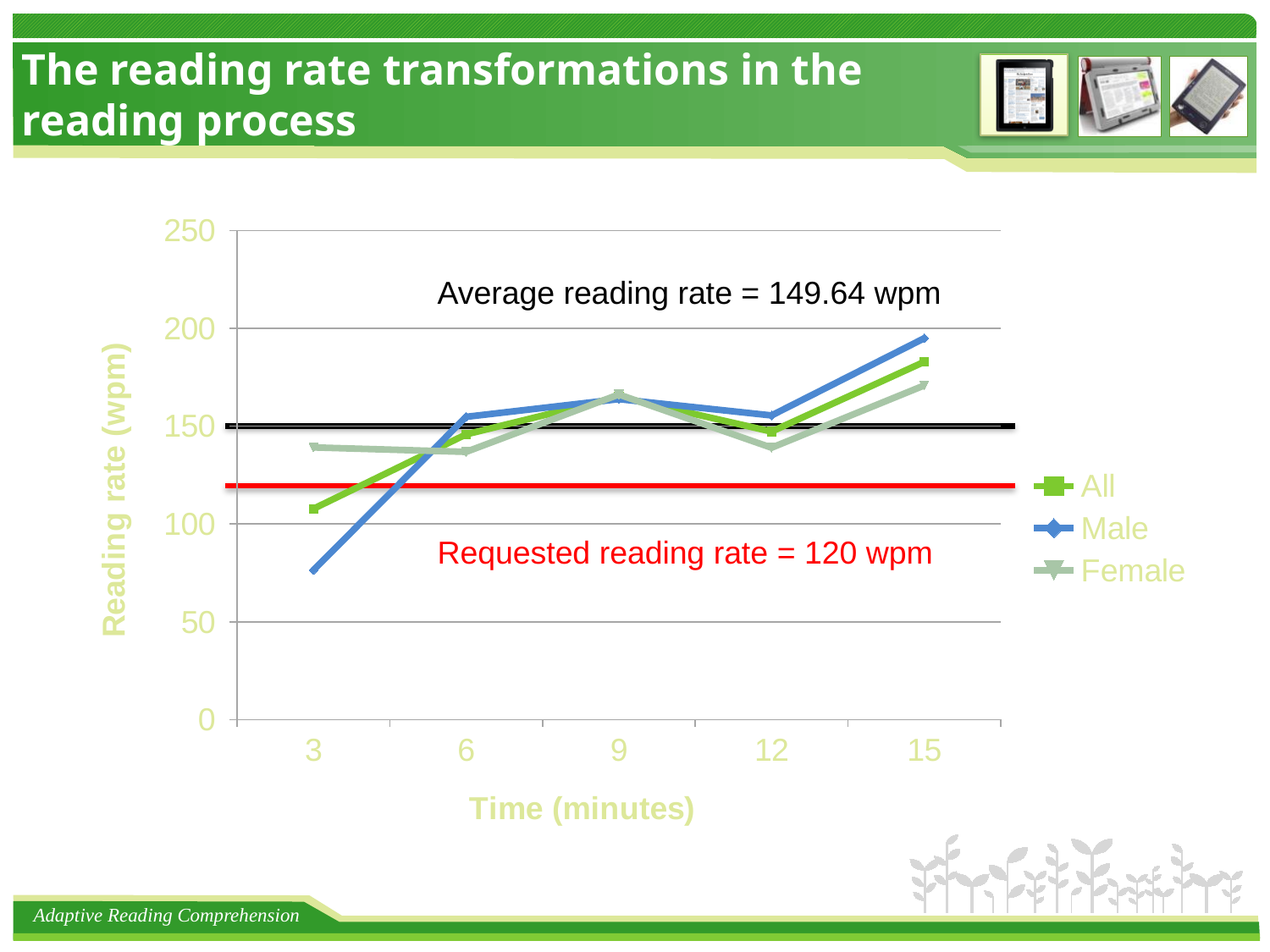
What average reading rate is stated on the chart? 149.64 wpm How many series does the legend list? 3 At which time point is the Male reading rate highest? 15 Is the Female reading rate at 15 minutes greater or less than 150? greater What kind of chart is shown on the slide? line chart Is the Male reading rate at 3 minutes greater or less than 100? less How many time points are plotted along the x axis? 5 Is the Male reading rate at 15 minutes greater or less than 200? less At 3 minutes, which series has the higher reading rate, Male or Female? Female At 15 minutes, which series has the higher reading rate, Male or Female? Male At which time point is the Male reading rate lowest? 3